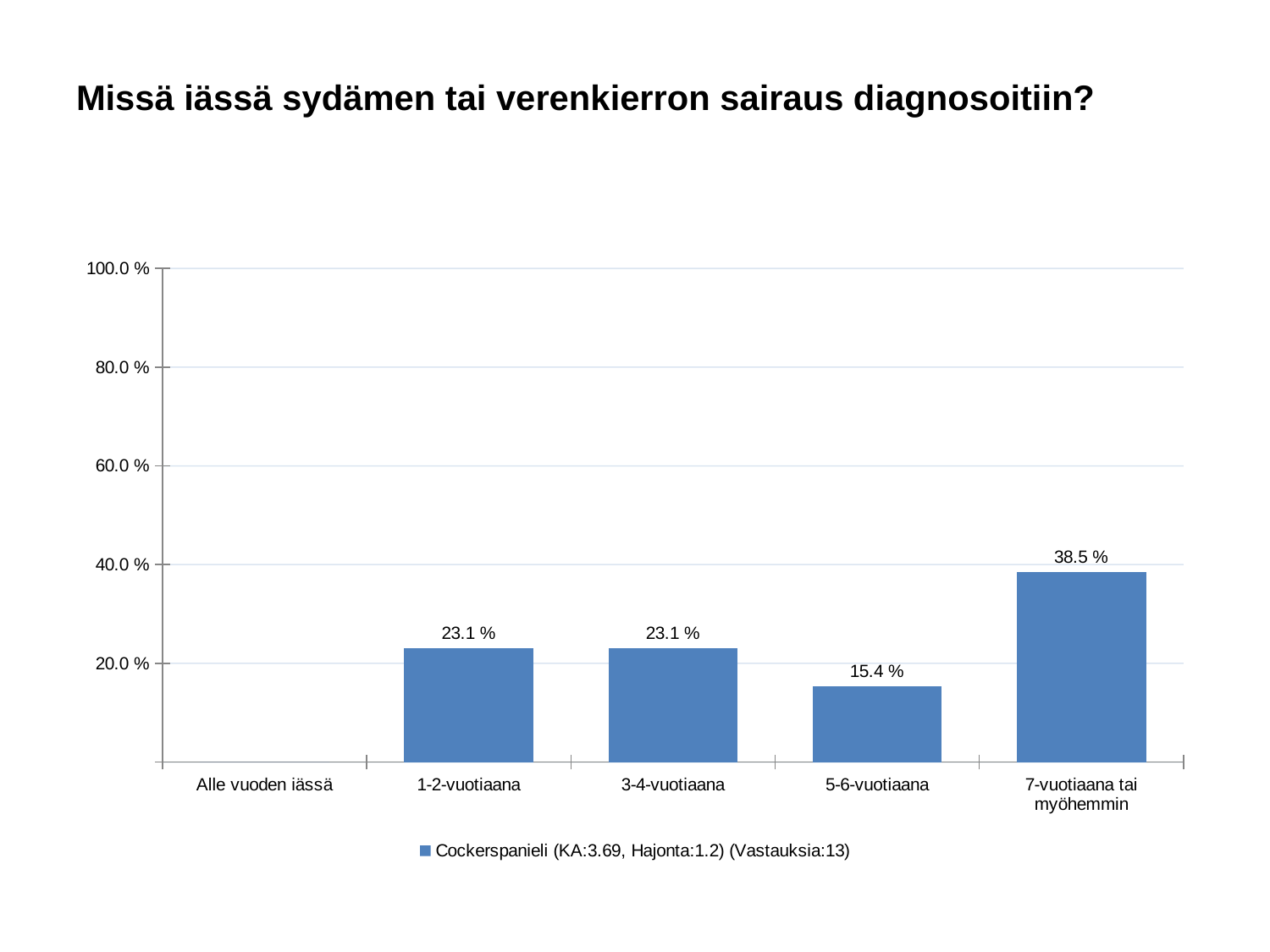
What is the difference between the values for 7-vuotiaana tai myöhemmin and 5-6-vuotiaana? 23.1 % How many series does the legend list? 1 Which category has the highest value? 7-vuotiaana tai myöhemmin What kind of chart is shown on the slide? bar chart How many responses (Vastauksia) does the legend entry report? 13 Is the value for 7-vuotiaana tai myöhemmin greater or less than 40.0 %? less What is the value for 7-vuotiaana tai myöhemmin? 38.5 % Which is larger, the value for 3-4-vuotiaana or the value for 5-6-vuotiaana? 3-4-vuotiaana What is the title of the chart? Missä iässä sydämen tai verenkierron sairaus diagnosoitiin? What is the value for 5-6-vuotiaana? 15.4 % How many categories are shown on the x axis? 5 What is the value for 1-2-vuotiaana? 23.1 %